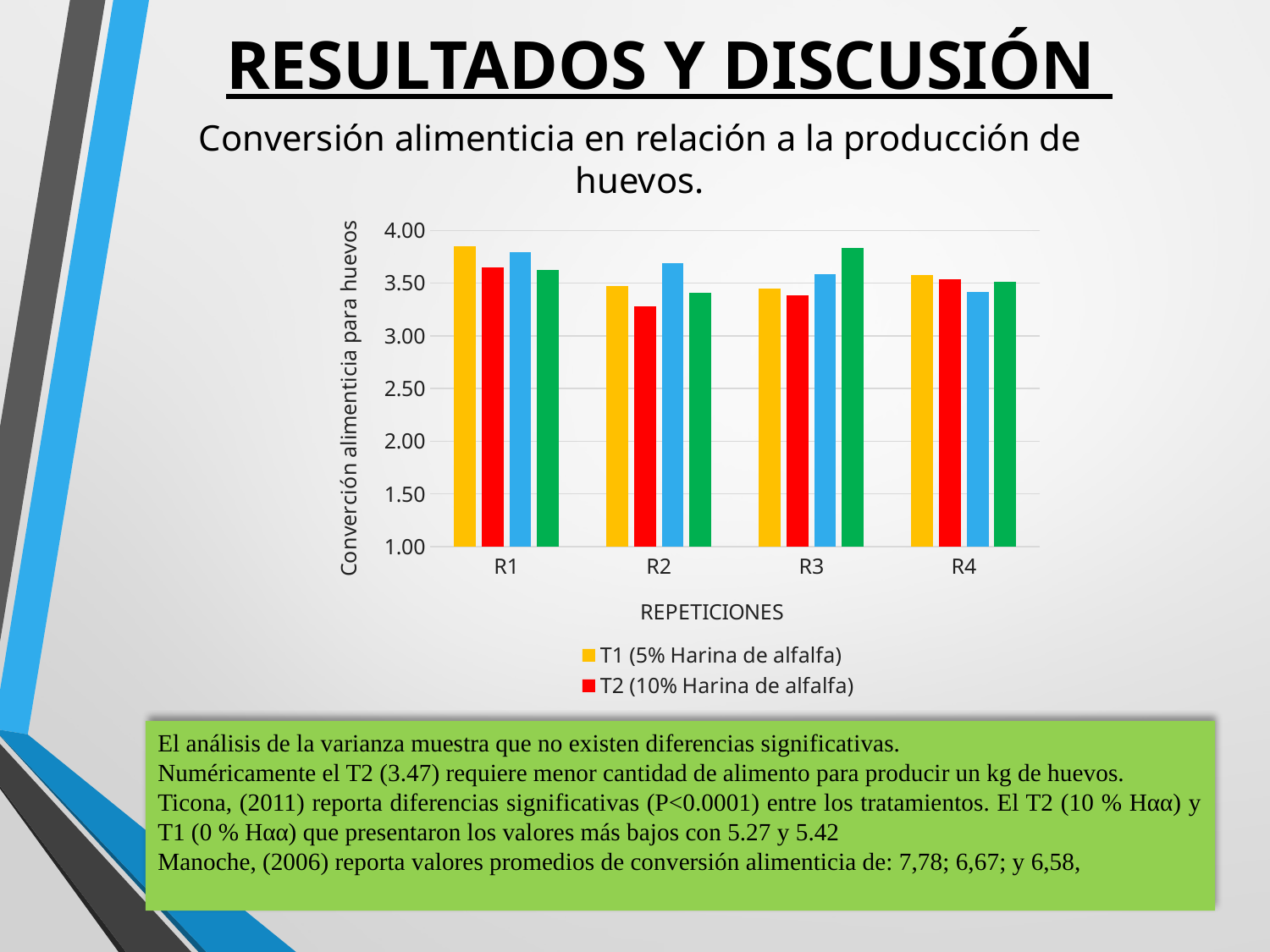
Is the value for T2 (10% Harina de alfalfa) at R3 greater or less than 3.00? greater What kind of chart is shown on the slide? bar chart Is the value for T2 (10% Harina de alfalfa) at R2 greater or less than 3.50? less What is the second legend entry shown below the chart? T2 (10% Harina de alfalfa) Which series has the lowest bar within the R2 group? T2 (10% Harina de alfalfa) Is the value for T1 (5% Harina de alfalfa) at R1 greater or less than 3.50? greater Which bar is the highest within the R2 group? the blue bar (third bar) What is the title of the x axis? REPETICIONES Is the value for T1 (5% Harina de alfalfa) larger at R1 or at R2? R1 Which bar is the highest within the R3 group? the green bar (fourth bar) How many bars are plotted for each repetition group? 4 How many repetition categories are shown on the x axis? 4